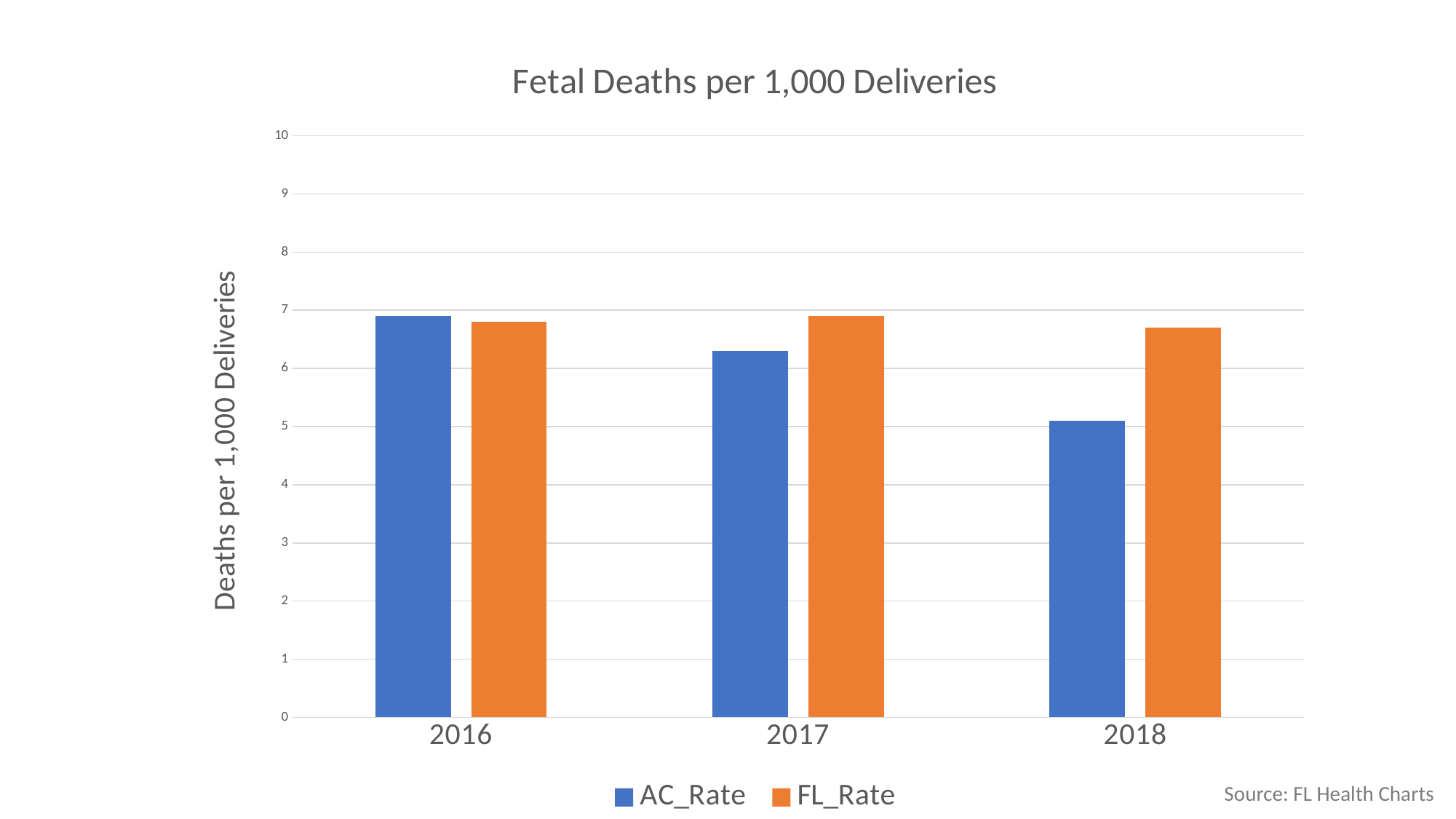
Which series is shown in orange? FL_Rate In 2018, which is larger, AC_Rate or FL_Rate? FL_Rate In which year is the AC_Rate bar highest? 2016 In which year is the AC_Rate bar lowest? 2018 What is the title of the chart? Fetal Deaths per 1,000 Deliveries Is the FL_Rate value for 2017 greater or less than 6? greater What kind of chart is shown on the slide? bar chart How many years are shown on the x axis? 3 Does the AC_Rate rise or fall from 2016 to 2018? fall How many series does the legend list? 2 In 2017, which is larger, AC_Rate or FL_Rate? FL_Rate Is the AC_Rate value for 2018 greater or less than 6? less